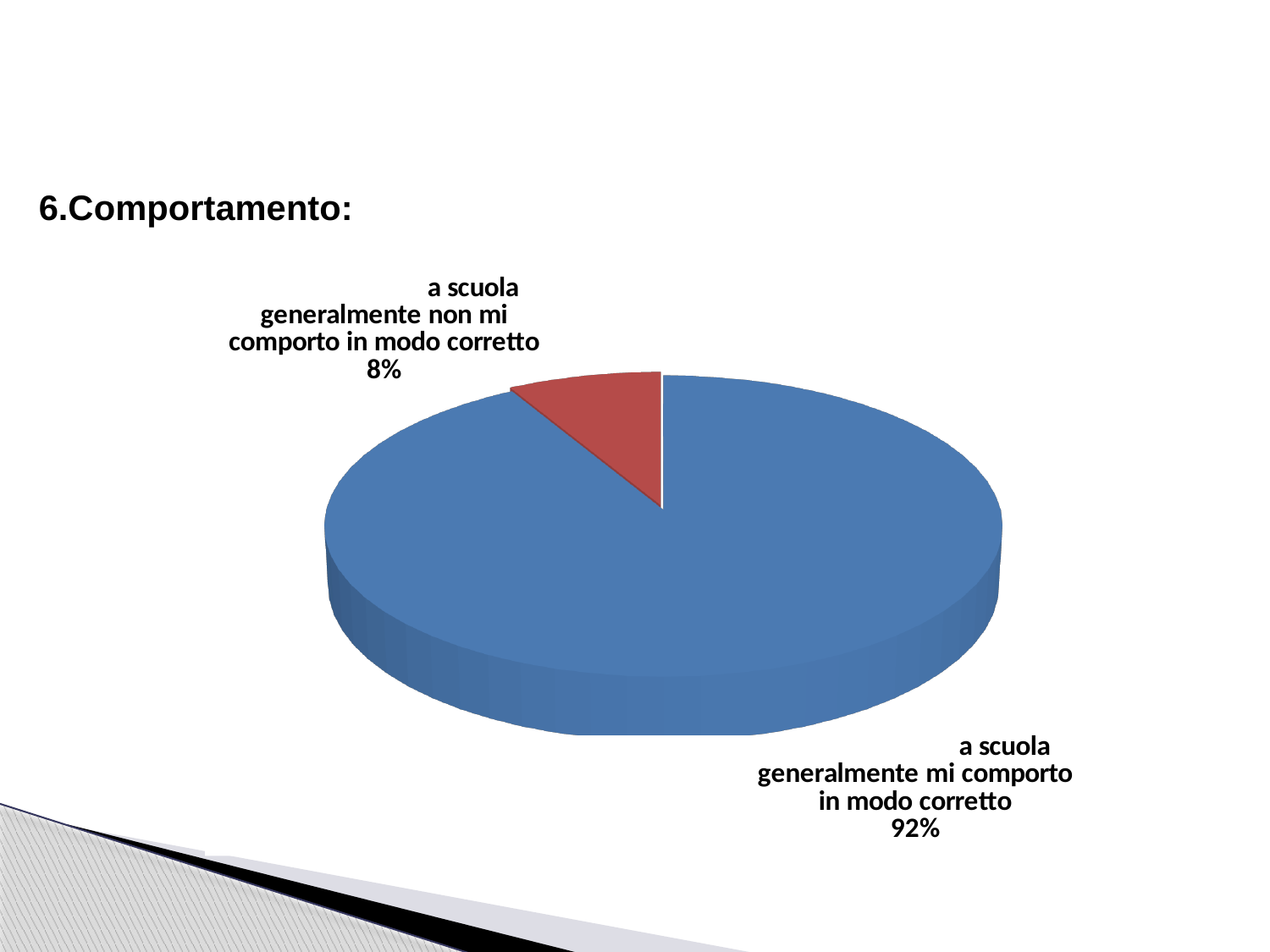
What share of the pie is labelled "a scuola generalmente non mi comporto in modo corretto"? 8% Which is larger: the share for "mi comporto in modo corretto" or the share for "non mi comporto in modo corretto"? a scuola generalmente mi comporto in modo corretto What is the heading shown above the pie chart? 6.Comportamento: What kind of chart is shown on the slide? pie chart What is the difference in percentage points between the two slices of the pie? 84 Which slice of the pie is the largest? a scuola generalmente mi comporto in modo corretto How many slices does the pie chart have? 2 What colour is the slice for "a scuola generalmente non mi comporto in modo corretto"? red Which slice of the pie is the smallest? a scuola generalmente non mi comporto in modo corretto What share of the pie is labelled "a scuola generalmente mi comporto in modo corretto"? 92%